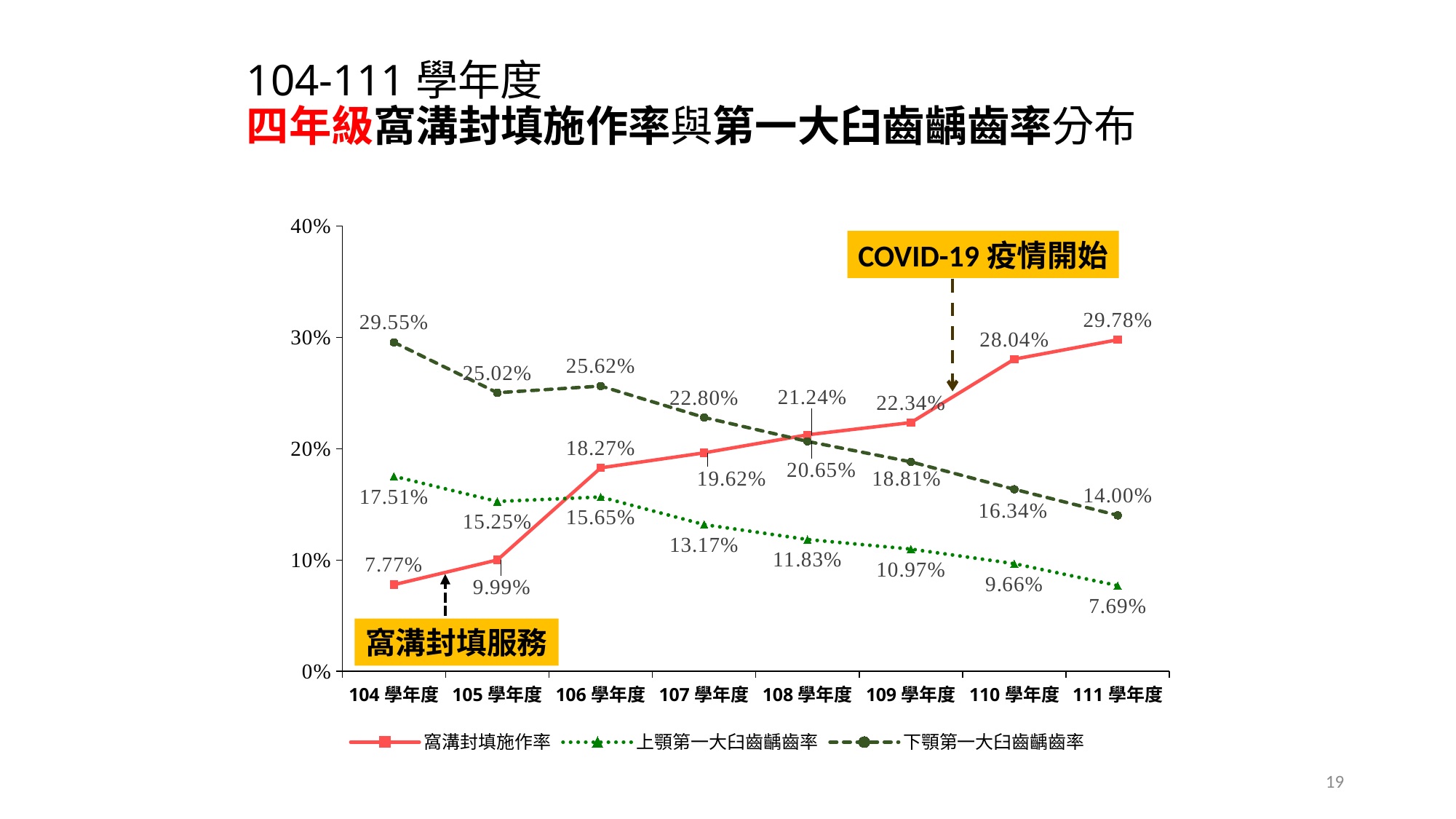
Which series is drawn with a solid red line? 窩溝封填施作率 What is the 上顎第一大臼齒齲齒率 value for 107 學年度? 13.17% What kind of chart is shown on the slide? Line chart How many 學年度 categories are shown on the x axis? 8 In which 學年度 is the 窩溝封填施作率 highest? 111 學年度 How many series does the legend list? 3 Does the 下顎第一大臼齒齲齒率 generally rise or fall from 104 學年度 to 111 學年度? Fall What is the 窩溝封填施作率 value for 104 學年度? 7.77% What is the difference between the 窩溝封填施作率 in 111 學年度 and in 104 學年度? 22.01% In which 學年度 is the 上顎第一大臼齒齲齒率 lowest? 111 學年度 What is the 下顎第一大臼齒齲齒率 value for 111 學年度? 14.00% Which is larger in 108 學年度: the 窩溝封填施作率 or the 下顎第一大臼齒齲齒率? 窩溝封填施作率